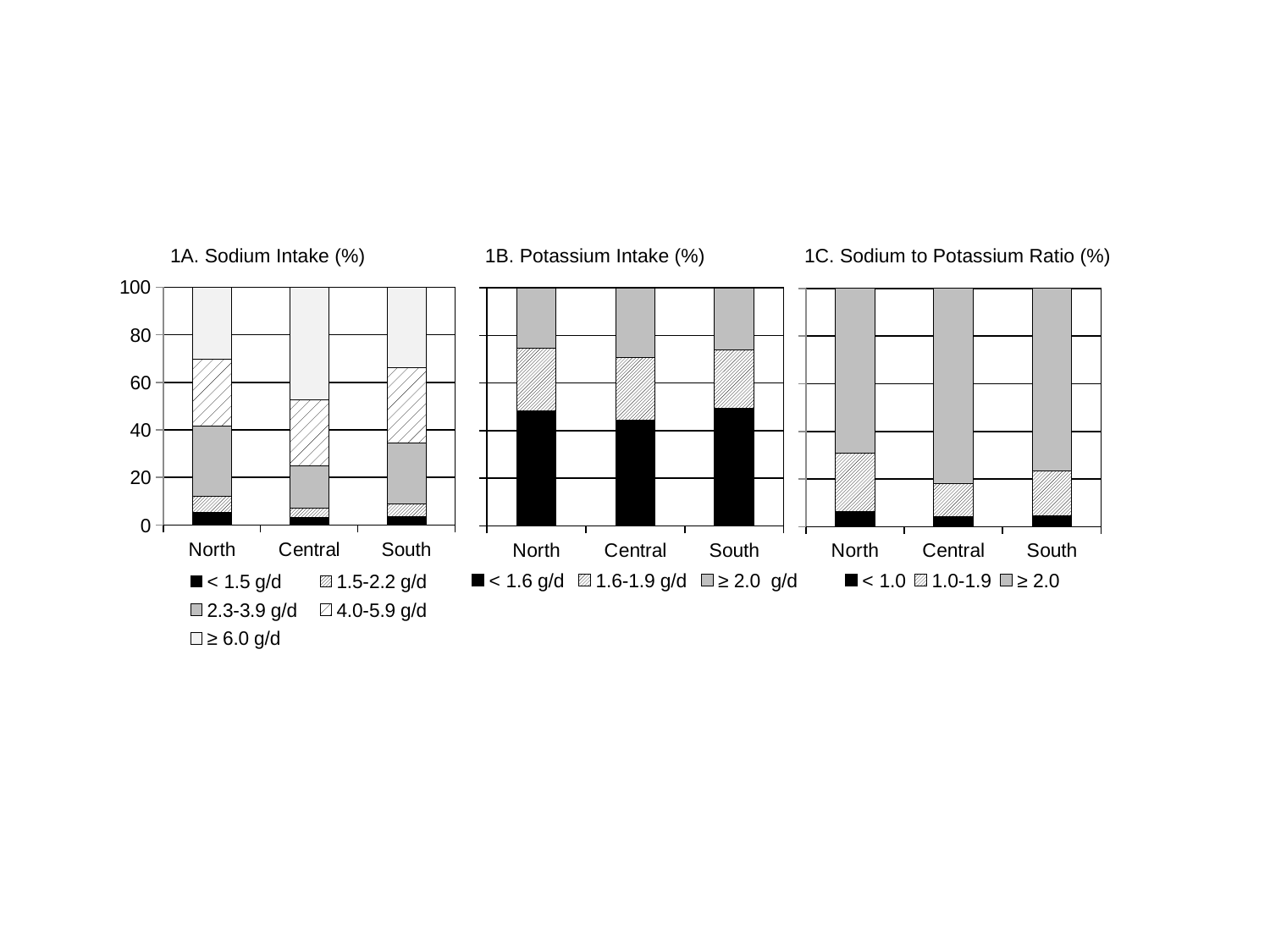
In 1A. Sodium Intake (%), what is the total height of the North stacked bar? 100 In 1A. Sodium Intake (%), which region has the largest ≥ 6.0 g/d segment? Central In 1B. Potassium Intake (%), which region has the smallest < 1.6 g/d segment? Central How many categories are shown on the x axis of 1C. Sodium to Potassium Ratio (%)? 3 In 1A. Sodium Intake (%), is the ≥ 6.0 g/d segment for Central greater or less than 40? greater In 1A. Sodium Intake (%), is the < 1.5 g/d segment for North greater or less than 20? less What kind of chart is 1A. Sodium Intake (%)? Stacked bar chart What is the title of the middle chart on the slide? 1B. Potassium Intake (%) In 1C. Sodium to Potassium Ratio (%), which region has the largest 1.0-1.9 segment? North How many series does the legend of 1B. Potassium Intake (%) list? 3 In 1C. Sodium to Potassium Ratio (%), is the ≥ 2.0 segment for North larger or smaller than the ≥ 2.0 segment for Central? smaller How many series does the legend of 1A. Sodium Intake (%) list? 5